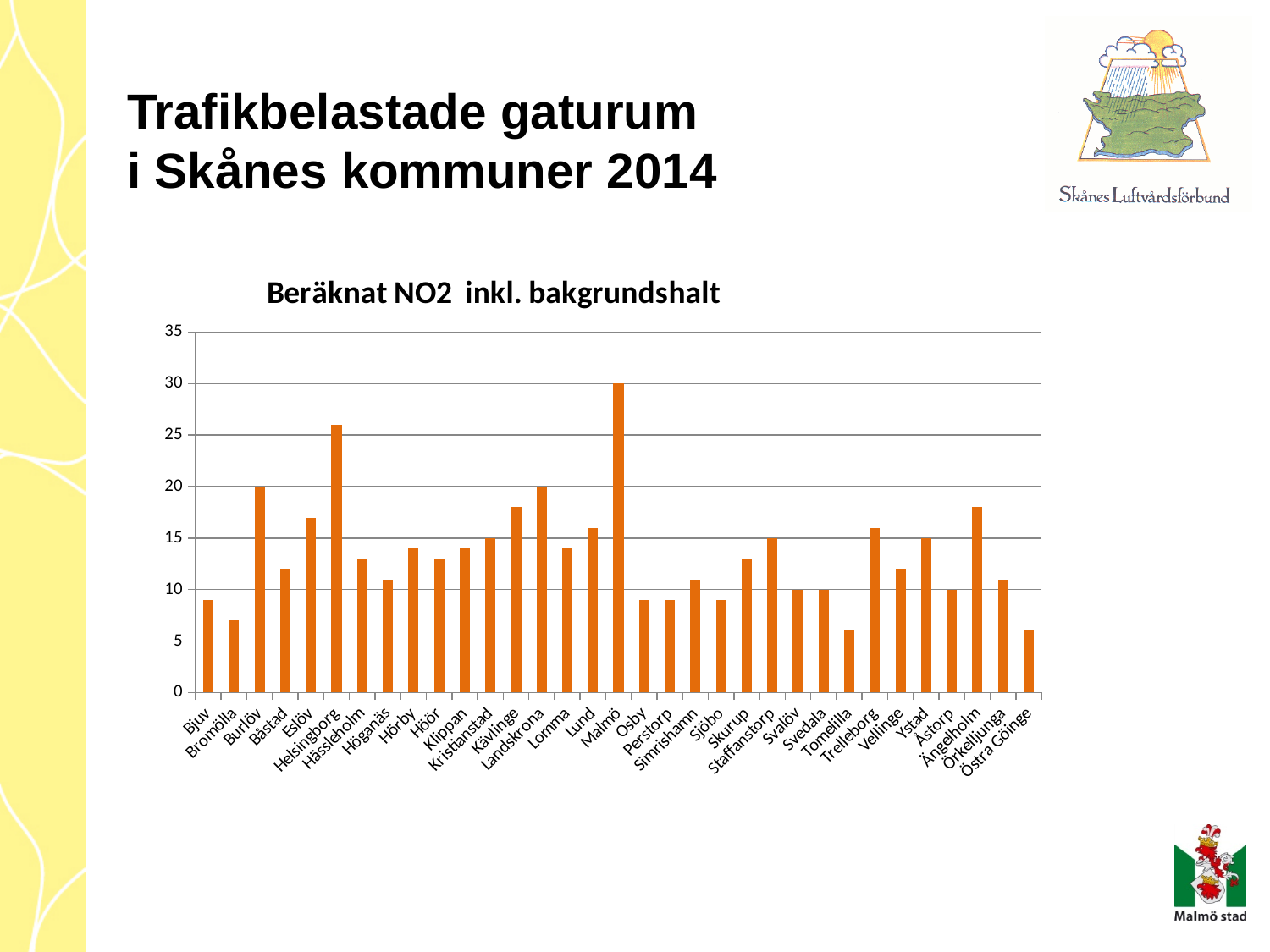
Which municipality has the highest value in the chart? Malmö What is the value for Svedala? 10 How many municipalities are shown on the x axis of the chart? 33 Which has the larger value, Helsingborg or Lund? Helsingborg What is the value for Landskrona? 20 What is the title of the chart? Beräknat NO2 inkl. bakgrundshalt Is the value for Helsingborg greater or less than 25? greater Is the value for Bjuv greater or less than 10? less What is the value for Malmö? 30 What is the value for Burlöv? 20 What is the value for Kristianstad? 15 What kind of chart is shown on the slide? bar chart